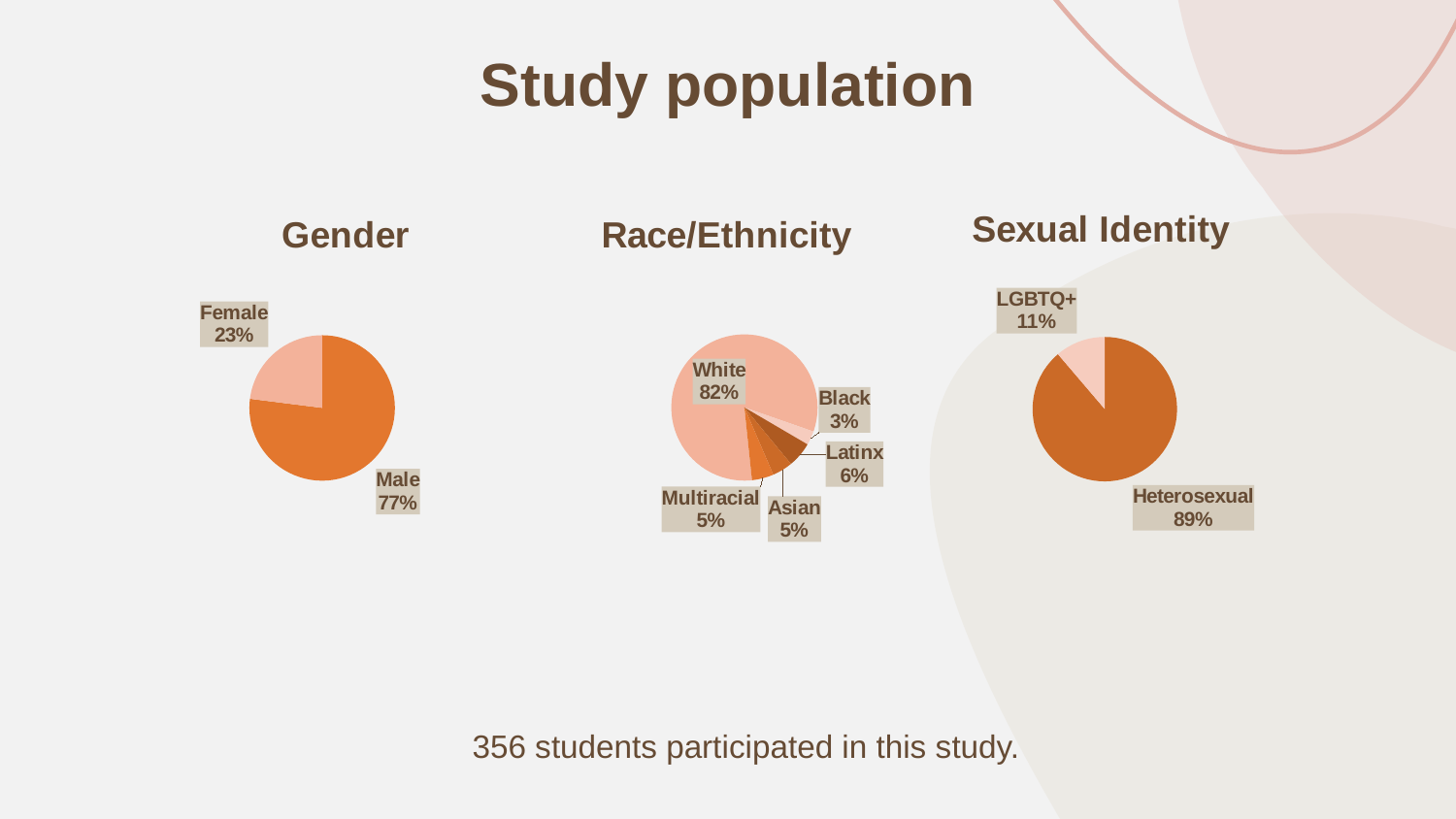
In the Gender chart, what percentage of participants are Female? 23% In the Sexual Identity chart, which category has the largest share? Heterosexual How many charts are shown on the slide? 3 In the Gender chart, what is the difference between the Male and Female shares? 54% In the Race/Ethnicity chart, what is the difference between the White and Latinx shares? 76% In the Race/Ethnicity chart, which category has the smallest share? Black In the Race/Ethnicity chart, what percentage of participants are Latinx? 6% In the Gender chart, what percentage of participants are Male? 77% In the Sexual Identity chart, what percentage of participants are LGBTQ+? 11% In the Race/Ethnicity chart, what percentage of participants are White? 82% What kind of chart is the Sexual Identity chart? Pie chart In the Race/Ethnicity chart, how many categories are shown? 5